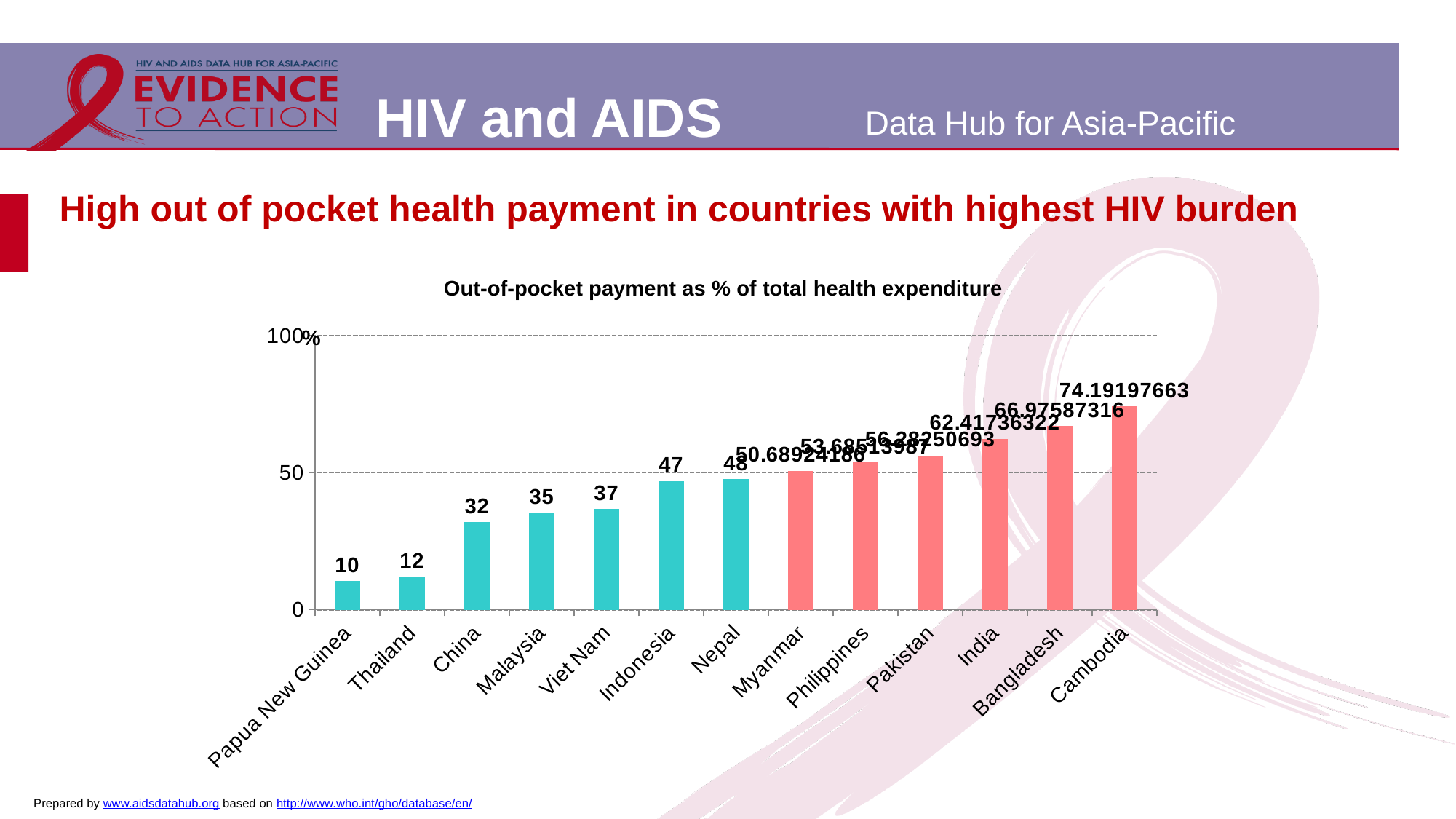
What is the title of the chart? Out-of-pocket payment as % of total health expenditure What value is shown for Cambodia? 74.19197663 What value is shown for Viet Nam? 37 Is the value for India greater or less than 50? greater What is the out-of-pocket payment as % of total health expenditure for Papua New Guinea? 10 Which country has the highest out-of-pocket payment as % of total health expenditure? Cambodia What is the difference between the values for Nepal and Indonesia? 1 What kind of chart is shown on the slide? bar chart How many countries are shown in the chart? 13 Which country has the lowest out-of-pocket payment as % of total health expenditure? Papua New Guinea Do the values rise or fall from left to right along the x axis? rise Which has a higher value, Malaysia or China? Malaysia